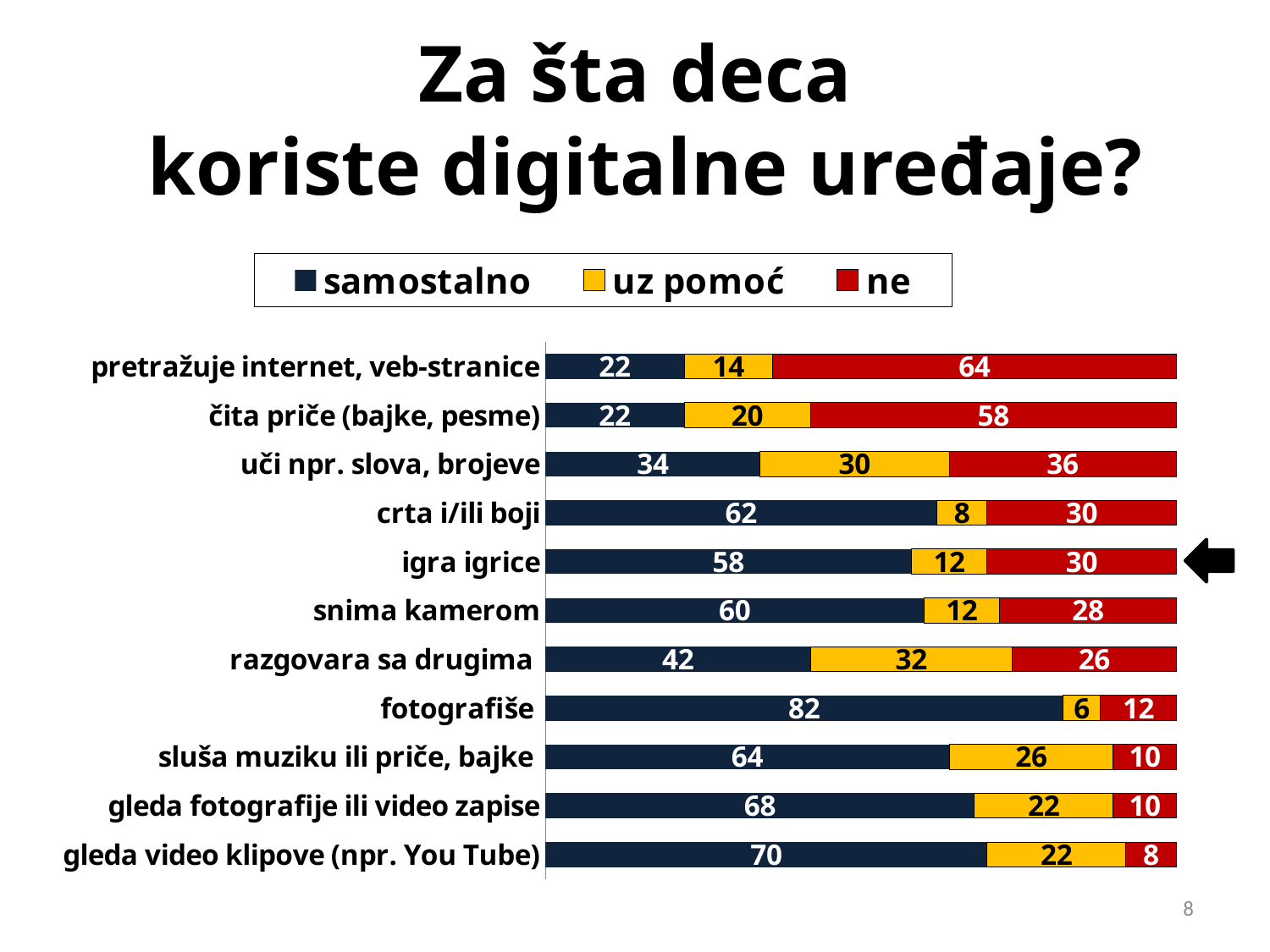
What is the 'ne' value for 'pretražuje internet, veb-stranice'? 64 How many categories (activities) are shown in the chart? 11 Which category has the highest 'samostalno' value? fotografiše How many series does the legend list? 3 What is the 'uz pomoć' value for 'razgovara sa drugima'? 32 What type of chart is shown on the slide? stacked bar chart Which legend entry is shown in red? ne What is the difference between the 'samostalno' values for 'gleda video klipove (npr. You Tube)' and 'uči npr. slova, brojeve'? 36 Which is larger: the 'uz pomoć' value for 'sluša muziku ili priče, bajke' or for 'snima kamerom'? sluša muziku ili priče, bajke What is the 'samostalno' value for 'fotografiše'? 82 Which category has the lowest 'ne' value? gleda video klipove (npr. You Tube) What is the total of the stacked bar for 'igra igrice'? 100